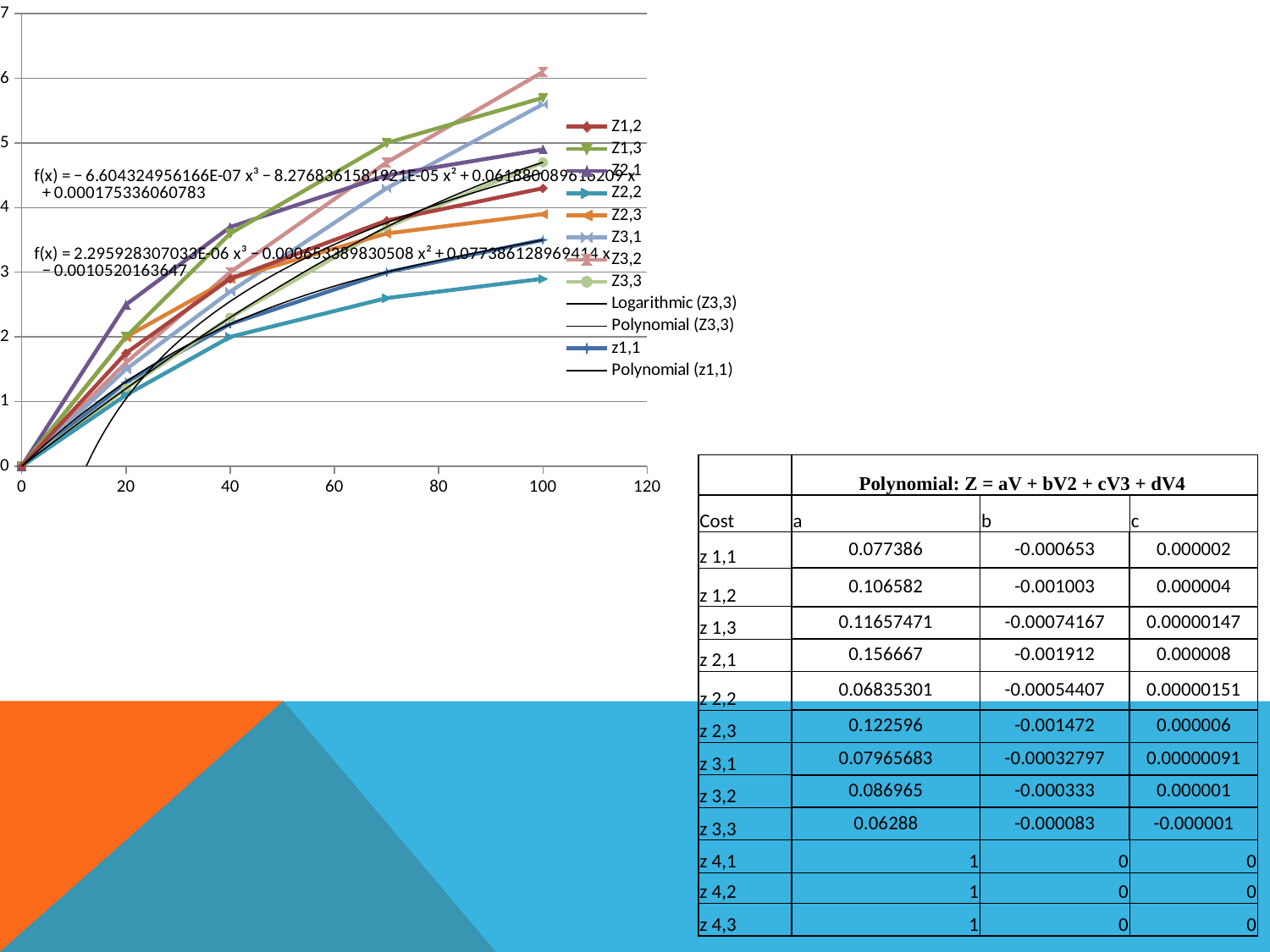
Which series has the highest value at x = 100? Z3,2 At x = 100, which is larger: Z3,2 or z1,1? Z3,2 Which series has the lowest value at x = 100? Z2,2 Is the value of Z3,2 at x = 70 greater or less than 4? greater Do the plotted series rise or fall as x increases from 0 to 100? rise What is the highest tick value shown on the chart's y axis? 7 What kind of chart is shown on the slide? line chart Which series has a logarithmic trendline listed in the legend? Z3,3 Is the value of Z2,2 at x = 100 greater or less than 4? less Is the value of Z3,2 at x = 100 greater or less than 5? greater How many entries does the chart's legend list? 12